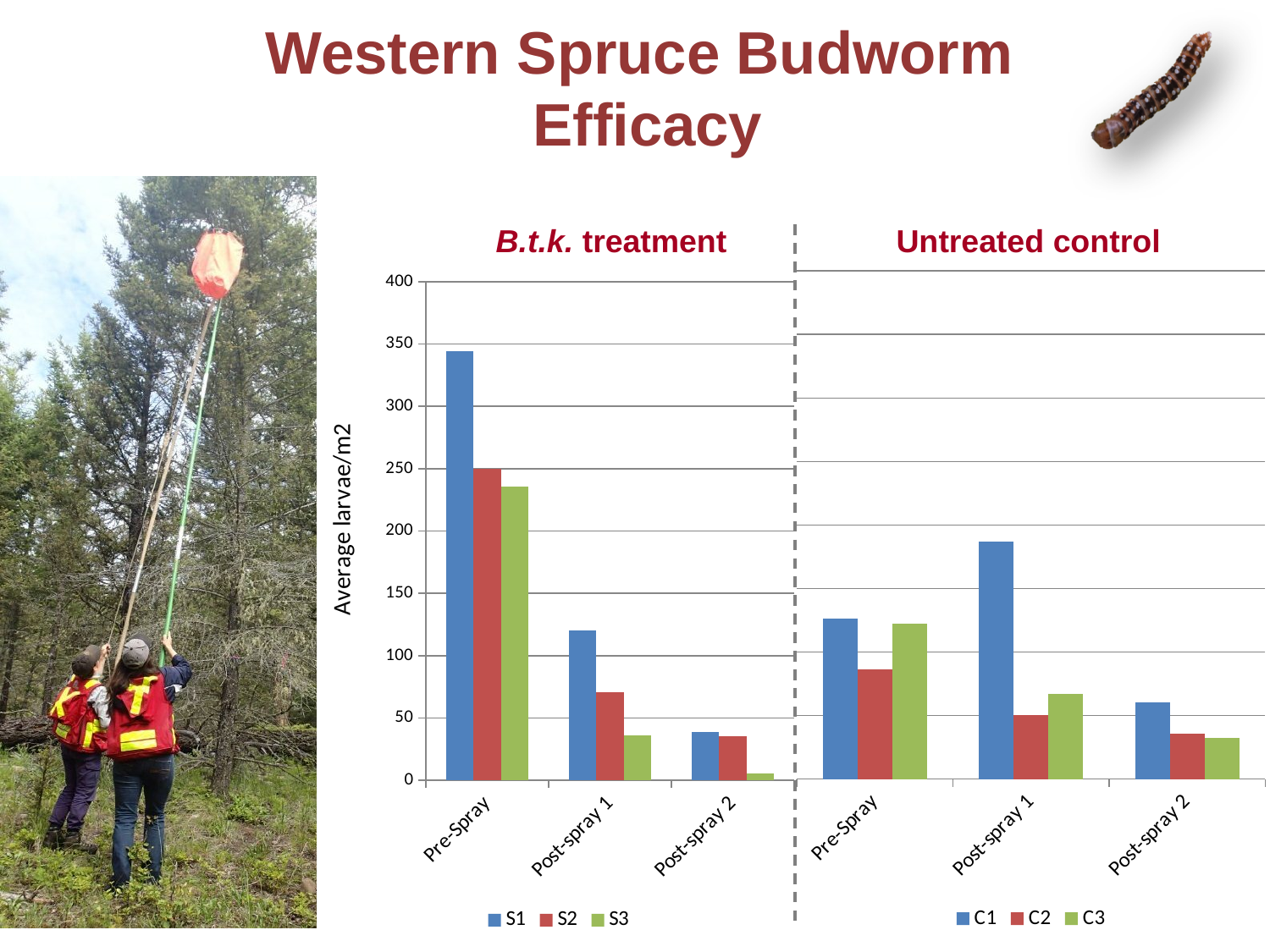
In the Untreated control chart, is the C1 value larger at Pre-Spray or at Post-spray 1? Post-spray 1 In the Untreated control chart, is the Post-spray 1 value for C1 greater or less than 150? greater In the B.t.k. treatment chart, which series and category has the highest bar? S1 at Pre-Spray How many sampling categories are shown on the x axis of the B.t.k. treatment chart? 3 In the B.t.k. treatment chart, do the S1 values rise or fall from Pre-Spray to Post-spray 2? fall What kind of chart is used for the B.t.k. treatment data? Bar chart In the B.t.k. treatment chart, is the Pre-Spray value for S1 greater or less than 300? greater In the B.t.k. treatment chart, which series and category has the lowest bar? S3 at Post-spray 2 What is the label on the y axis of the charts? Average larvae/m2 In the Untreated control chart, what are the legend entries? C1, C2, C3 In the B.t.k. treatment chart, is the Post-spray 1 value for S2 greater or less than 100? less In the B.t.k. treatment chart, how many series does the legend list? 3